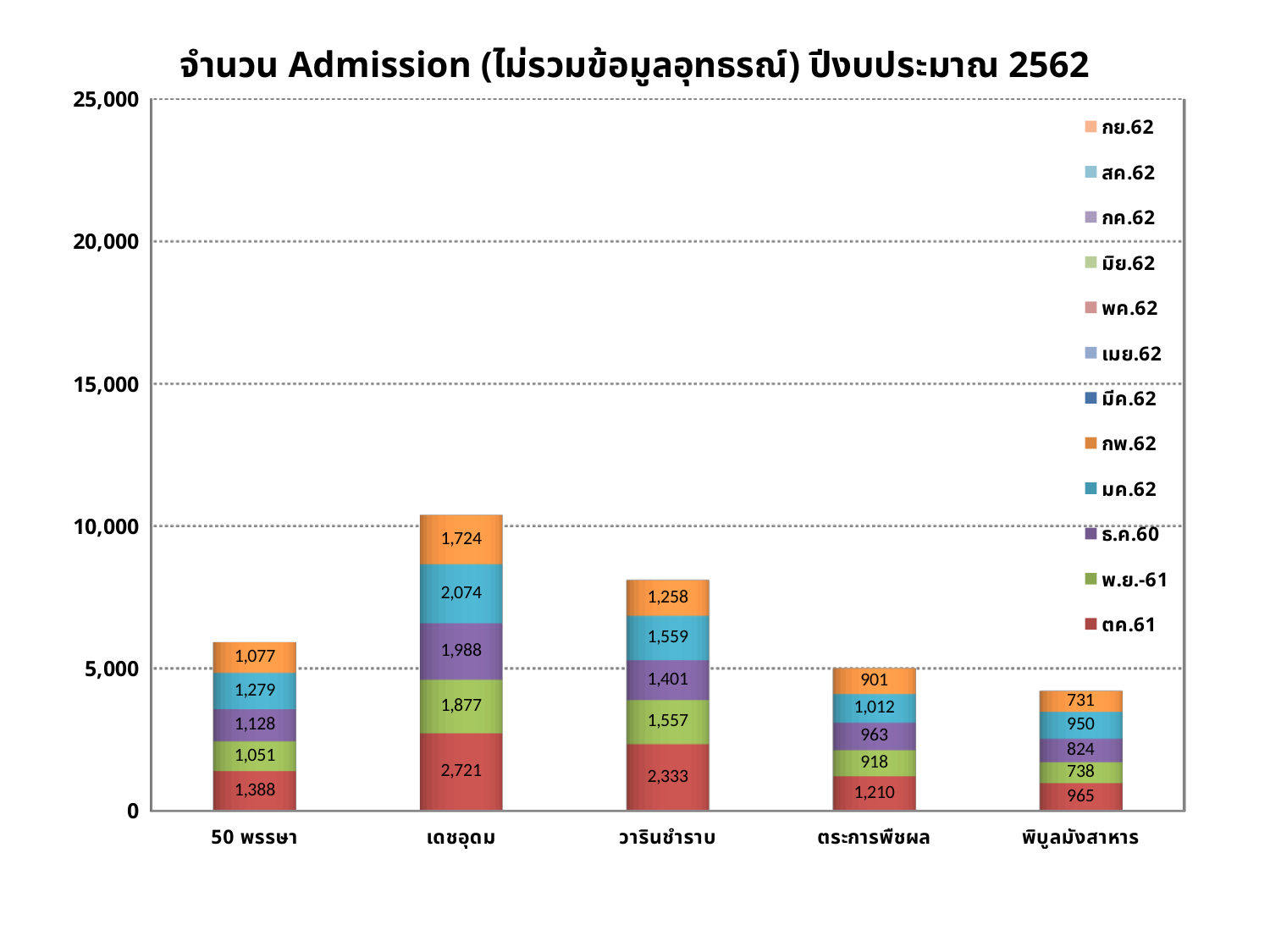
What is the value of the ตค.61 segment for เดชอุดม? 2,721 What is the value of the กพ.62 segment for พิบูลมังสาหาร? 731 Which hospital has the tallest stacked bar? เดชอุดม How many hospitals (categories) are shown on the x axis? 5 What kind of chart is shown on the slide? stacked bar chart How many series does the legend list? 12 Which is larger, the พ.ย.-61 value for 50 พรรษา or the พ.ย.-61 value for ตระการพืชผล? 50 พรรษา What is the total of the stacked bar for ตระการพืชผล? 5,004 What is the difference between the ตค.61 values for เดชอุดม and วารินชำราบ? 388 What is the value of the มค.62 segment for วารินชำราบ? 1,559 Which hospital has the shortest stacked bar? พิบูลมังสาหาร Is the total stacked bar for เดชอุดม greater or less than 10,000? greater